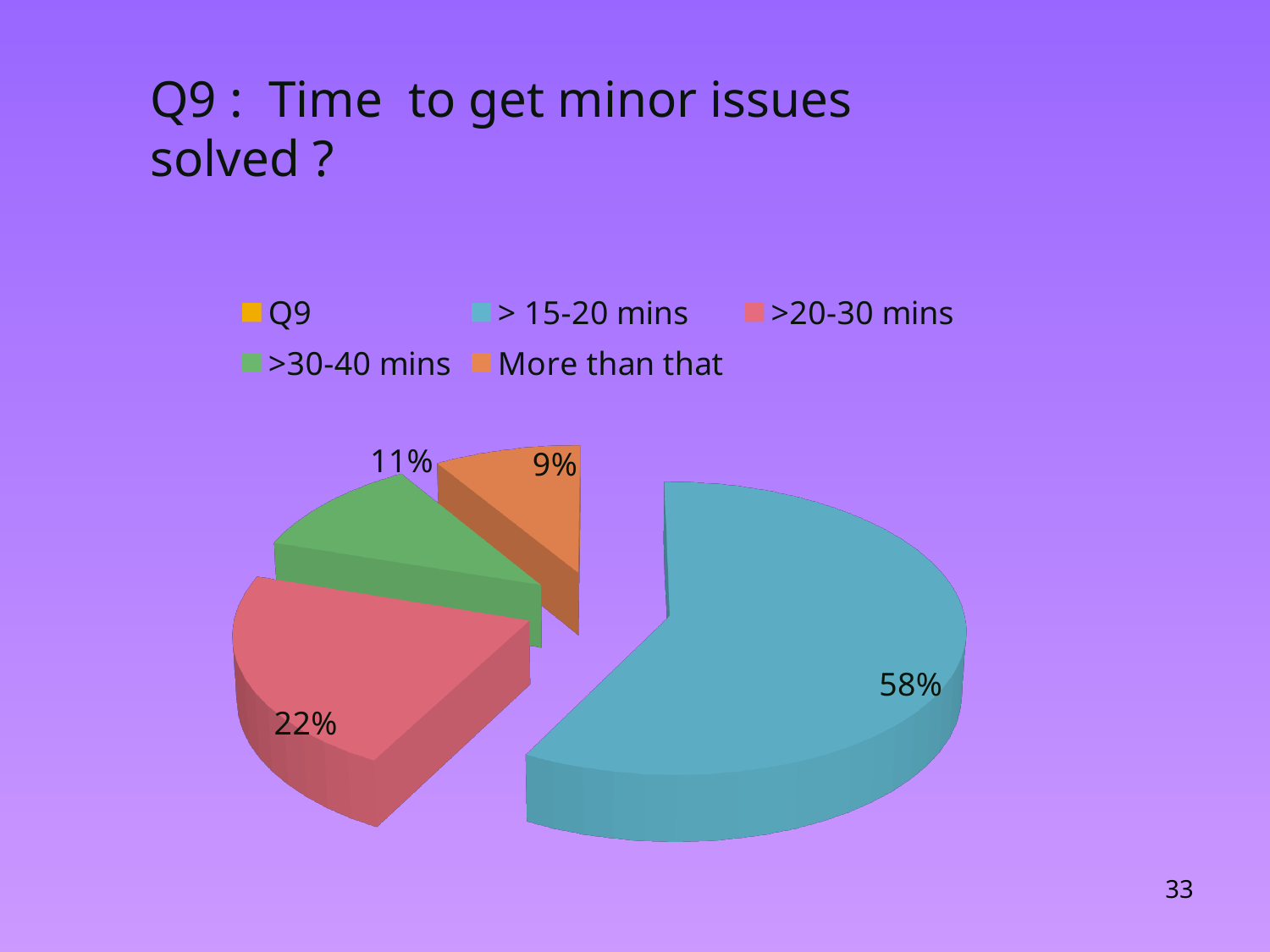
How many entries does the chart legend list? 5 What kind of chart is shown on the slide? Pie chart Which category has the largest slice of the pie? > 15-20 mins What colour is the ">20-30 mins" slice in the pie chart? Red Which slice is larger, ">30-40 mins" or "More than that"? >30-40 mins What share of the pie does the "> 15-20 mins" slice represent? 58% What share of the pie does the ">20-30 mins" slice represent? 22% Which category has the smallest slice of the pie? More than that How many slices with data labels are shown in the pie chart? 4 What is the difference in percentage points between the "> 15-20 mins" slice and the ">20-30 mins" slice? 36 What share of the pie does the "More than that" slice represent? 9% What share of the pie does the ">30-40 mins" slice represent? 11%